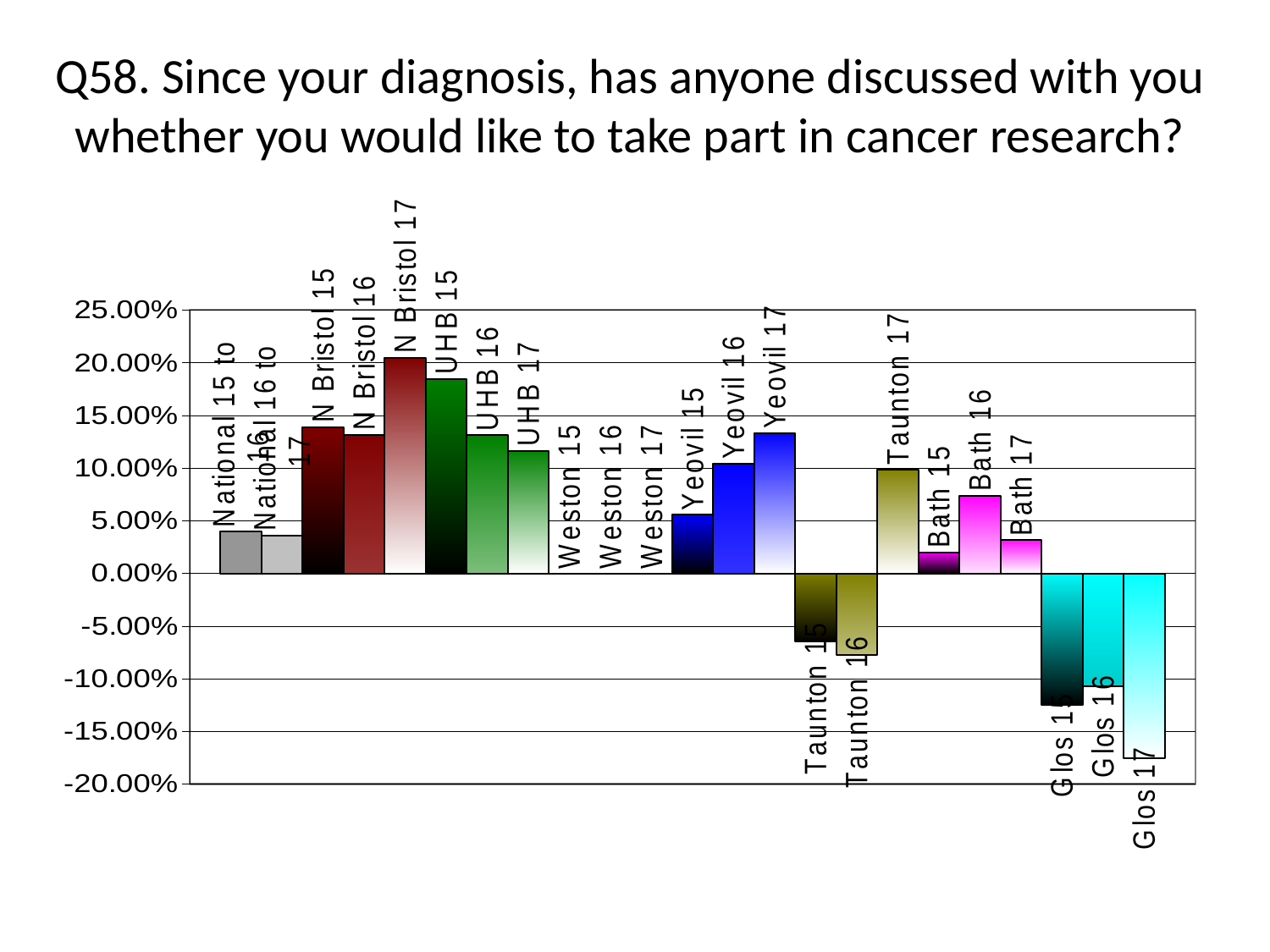
Which is larger, the value for Yeovil 17 or the value for Yeovil 15? Yeovil 17 Is the value for Glos 17 greater or less than -15.00%? less What is the title of the slide above the chart? Q58. Since your diagnosis, has anyone discussed with you whether you would like to take part in cancer research? Which category has the lowest value in the chart? Glos 17 Is the value for UHB 15 greater or less than 20.00%? less Which is larger, the value for UHB 15 or the value for UHB 17? UHB 15 Which category has the highest value in the chart? N Bristol 17 What kind of chart is shown on the slide? bar chart Is the value for Taunton 16 greater or less than -5.00%? less How many category labels are shown along the x axis of the chart? 23